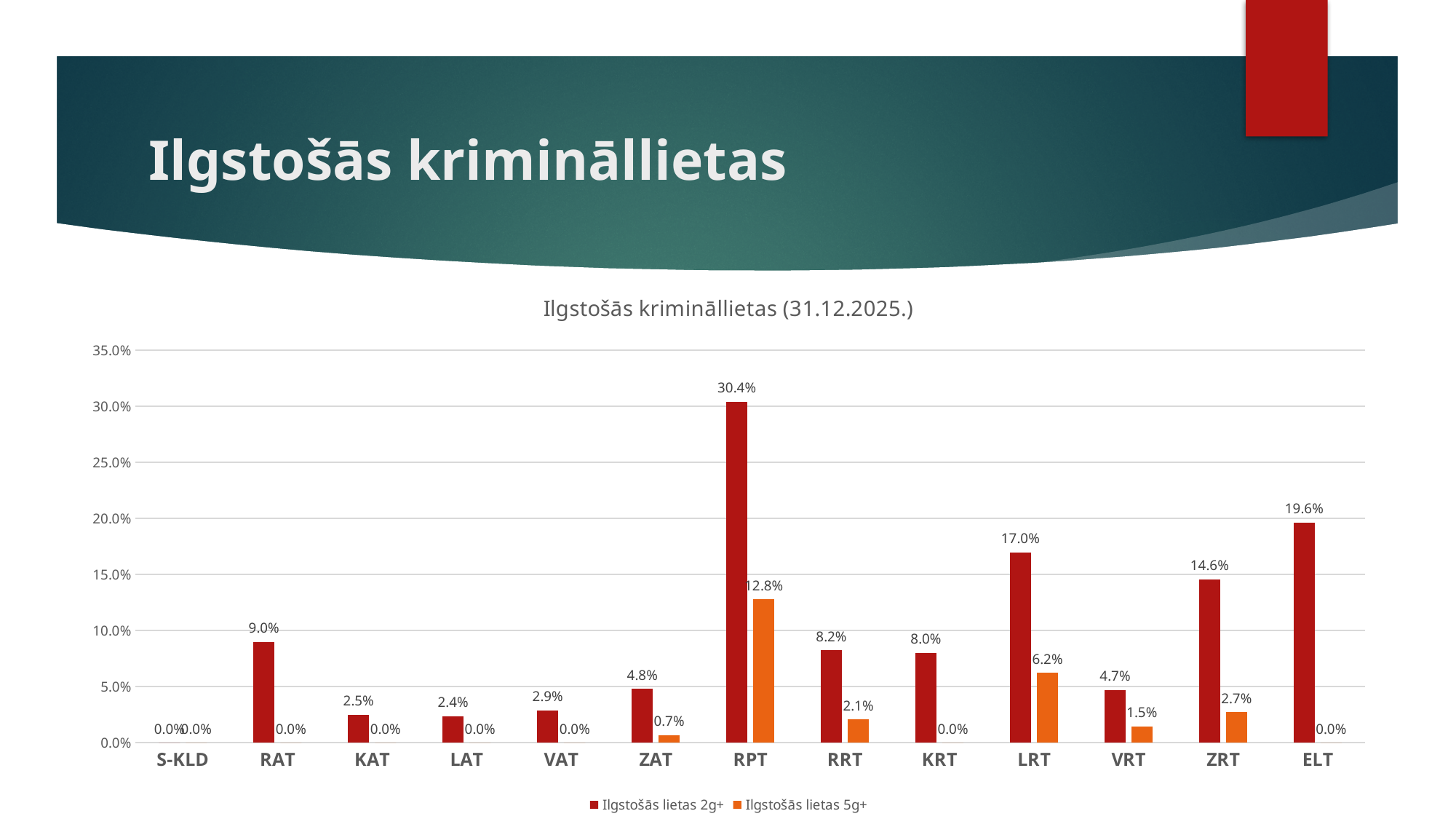
Which category has the highest value for 'Ilgstošās lietas 5g+'? RPT What is the title of the chart? Ilgstošās krimināllietas (31.12.2025.) Which is larger, the 'Ilgstošās lietas 2g+' value for RRT or for KRT? RRT What kind of chart is shown on the slide? bar chart What is the value of 'Ilgstošās lietas 2g+' for RPT? 30.4% What is the difference between the 'Ilgstošās lietas 2g+' values for ELT and LRT? 2.6% What is the value of 'Ilgstošās lietas 2g+' for ZRT? 14.6% How many series does the legend list? 2 What is the value of 'Ilgstošās lietas 5g+' for LRT? 6.2% How many categories are shown on the x axis? 13 Which category has the highest value for 'Ilgstošās lietas 2g+'? RPT Is the 'Ilgstošās lietas 2g+' value for RPT greater or less than 30.0%? greater